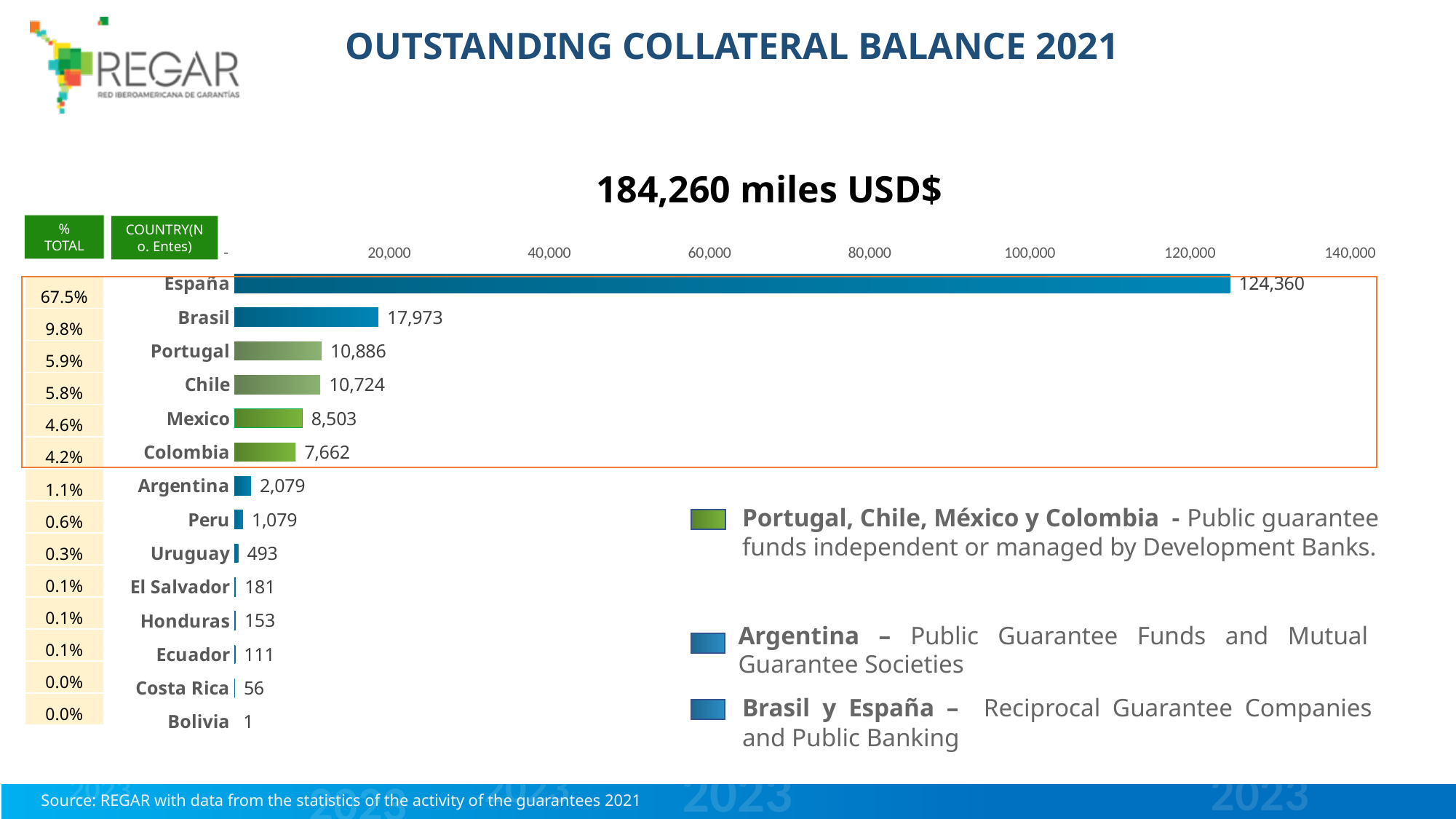
What kind of chart is shown on the slide? Bar chart What value is shown for Chile? 10,724 What value is shown for Argentina? 2,079 Which country has the highest outstanding collateral balance? España How many countries are shown in the chart? 14 What is the difference between the values for Mexico and Colombia? 841 What total is given in the chart title above the bars? 184,260 miles USD$ What is the outstanding collateral balance value shown for Brasil? 17,973 Which country has the lowest outstanding collateral balance? Bolivia Which has a larger value, Portugal or Chile? Portugal Is the value for España greater or less than 120,000? greater What is the difference between the values for España and Brasil? 106,387